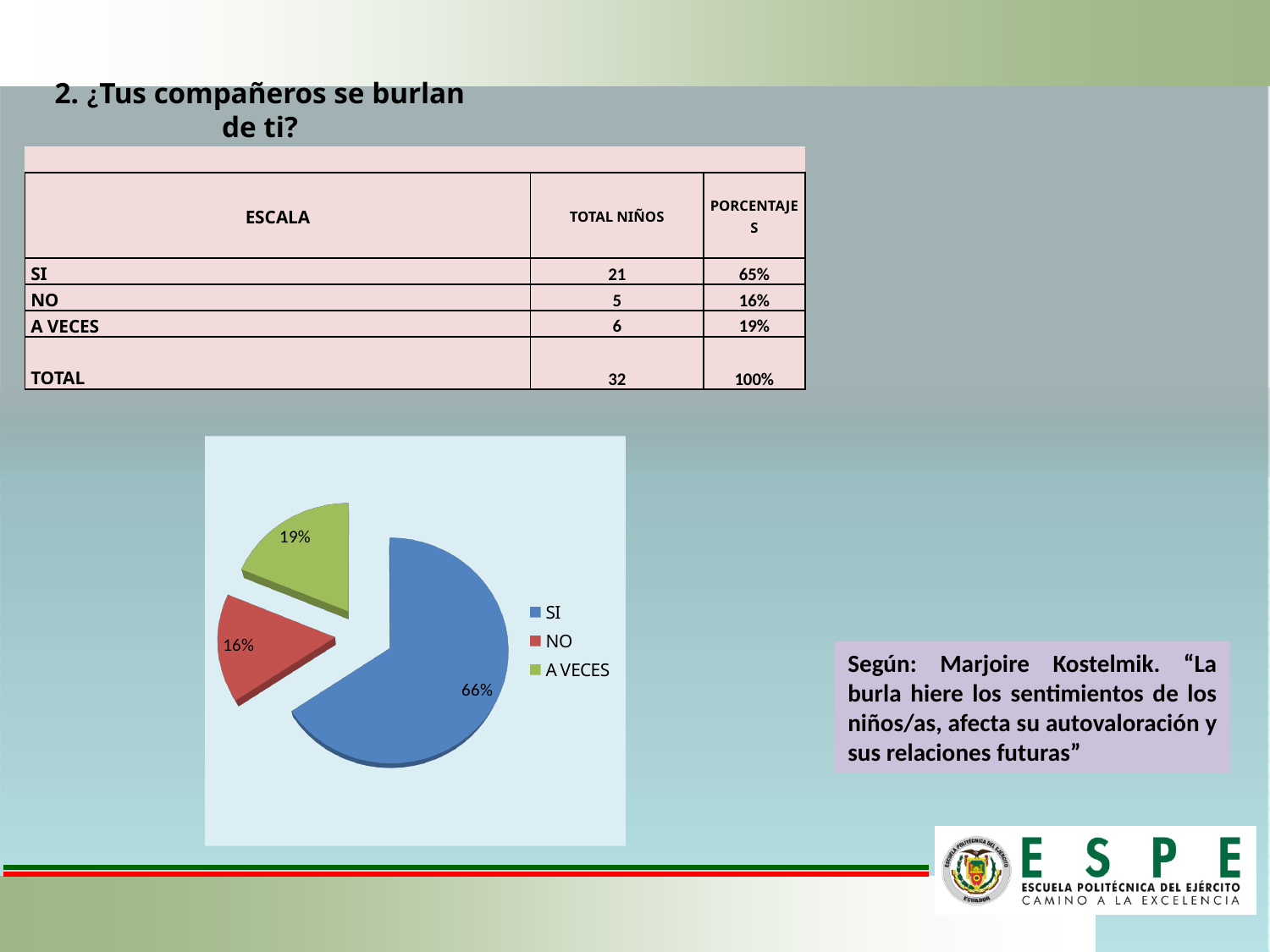
How many slices does the pie chart have? 3 What percentage does the pie chart show for A VECES? 19% How many entries does the pie chart legend list? 3 What colour is the A VECES slice in the pie chart? green What kind of chart is shown on the slide? pie chart Which slice is larger in the pie chart, NO or A VECES? A VECES What percentage does the pie chart show for NO? 16% What colour is the SI slice in the pie chart? blue Which category has the largest slice in the pie chart? SI What percentage does the pie chart show for SI? 66% What is the difference in percentage points between the SI slice and the A VECES slice in the pie chart? 47 Which category has the smallest slice in the pie chart? NO